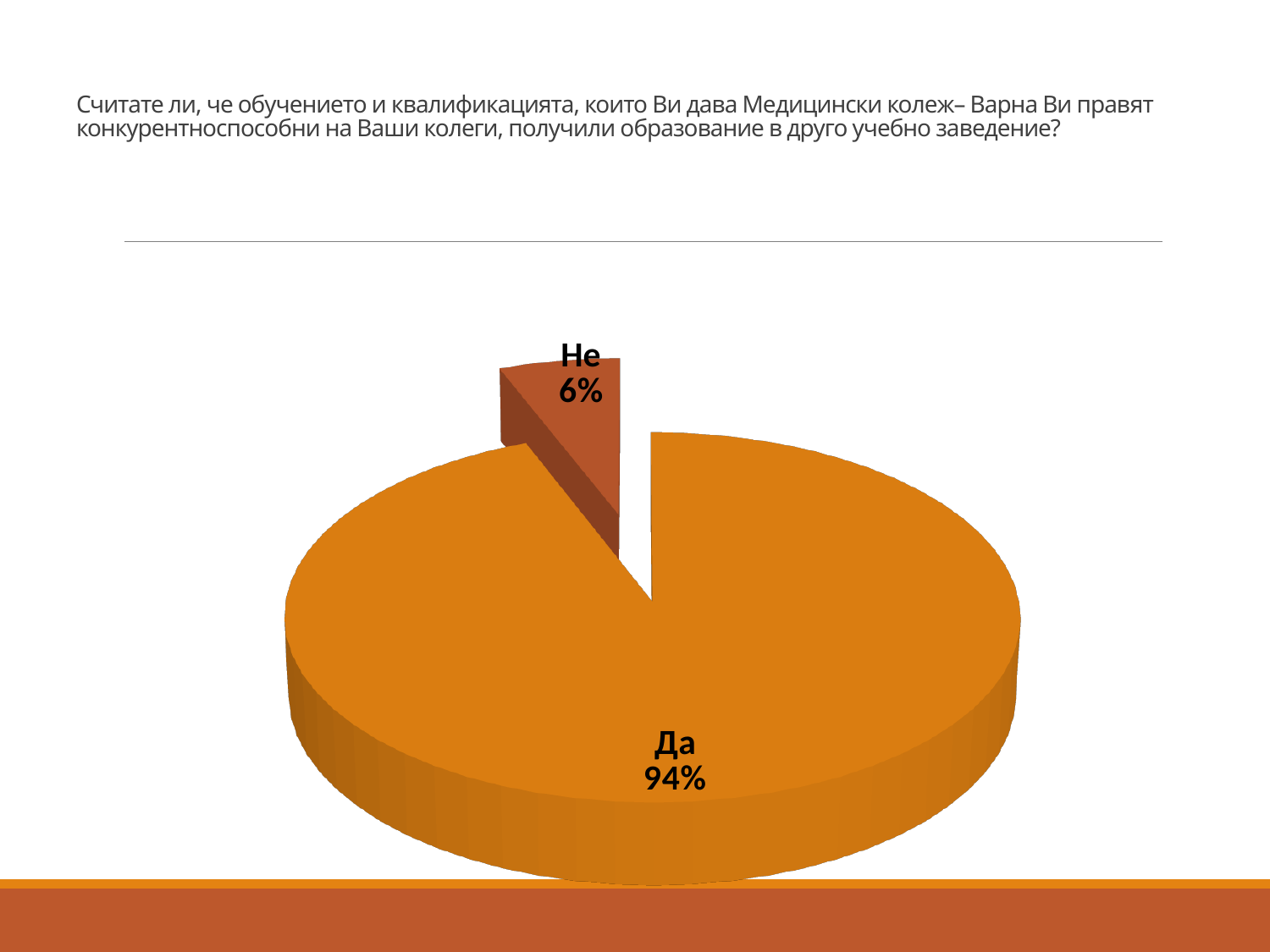
How many slices does the pie chart have? 2 What share of the pie does the "Не" slice represent? 6% Is the value for "Да" greater or less than 50%? greater Is the value for "Не" greater or less than 10%? less What colour is the "Не" slice in the pie chart? brown (dark orange) Which slice is the smallest in the pie chart? Не Which slice is larger, "Да" or "Не"? Да Which slice is pulled out (exploded) from the pie? Не What is the difference in percentage points between the "Да" and "Не" slices? 88 What share of the pie does the "Да" slice represent? 94% Which slice is the largest in the pie chart? Да What kind of chart is shown on the slide? pie chart